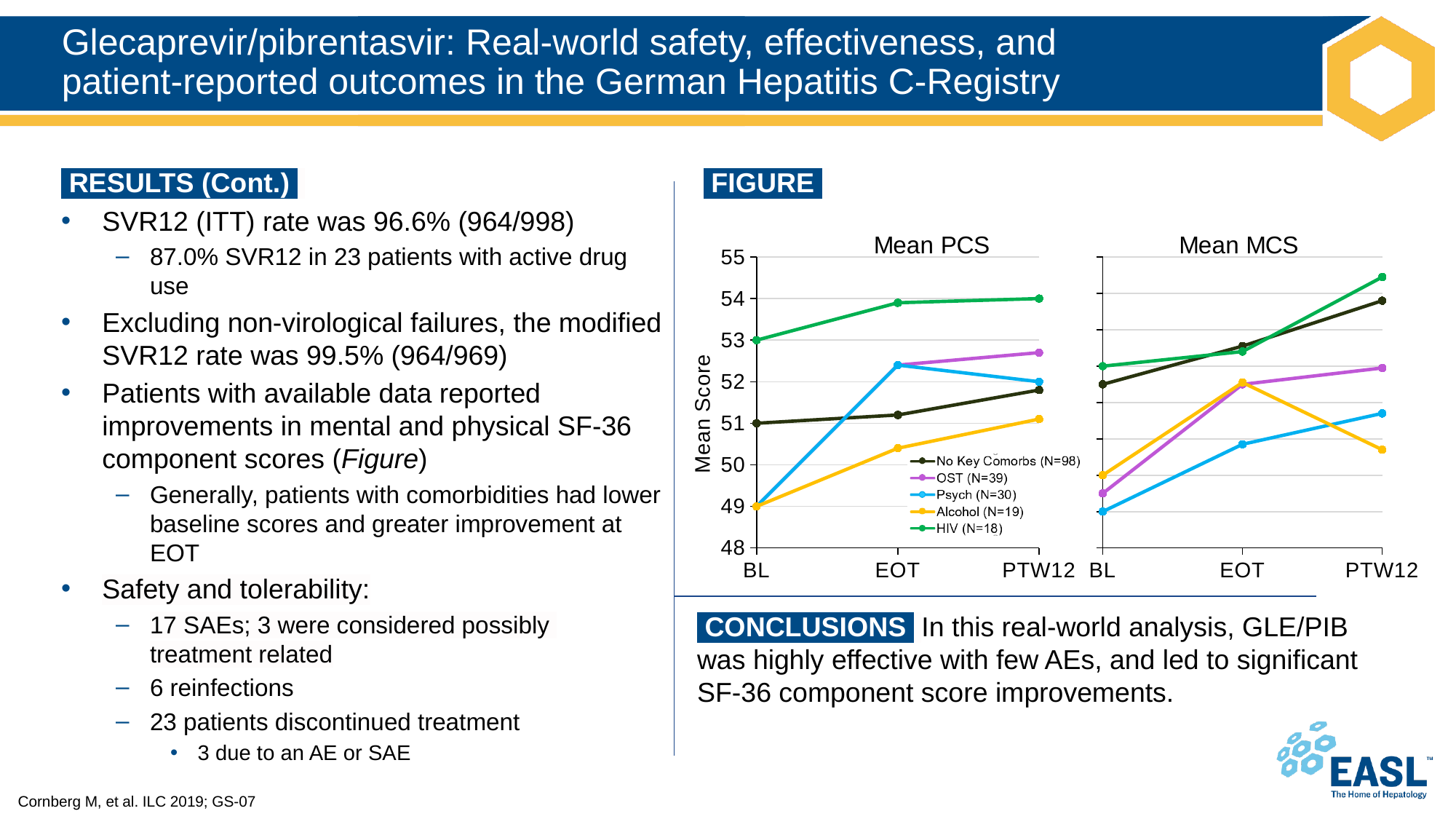
In the Mean MCS chart, which group has the lowest score at BL? Psych (N=30) How many series does the legend list in the figure? 5 In the Mean MCS chart, which is larger at PTW12: OST (N=39) or Psych (N=30)? OST (N=39) In the Mean MCS chart, which group has the highest score at PTW12? HIV (N=18) In the Mean PCS chart, is the value for HIV (N=18) at EOT greater or less than 53? greater In the Mean PCS chart, does the Psych (N=30) line rise or fall from EOT to PTW12? fall In the Mean PCS chart, which group has the lowest score at PTW12? Alcohol (N=19) What is the label of the y axis in the figure? Mean Score What type of chart is used for the Mean PCS and Mean MCS panels? line chart In the Mean PCS chart, which group has the highest score at BL? HIV (N=18) How many time points are shown on the x axis of the Mean PCS chart? 3 In the Mean MCS chart, is the value for Alcohol (N=19) at PTW12 greater or less than 51? less